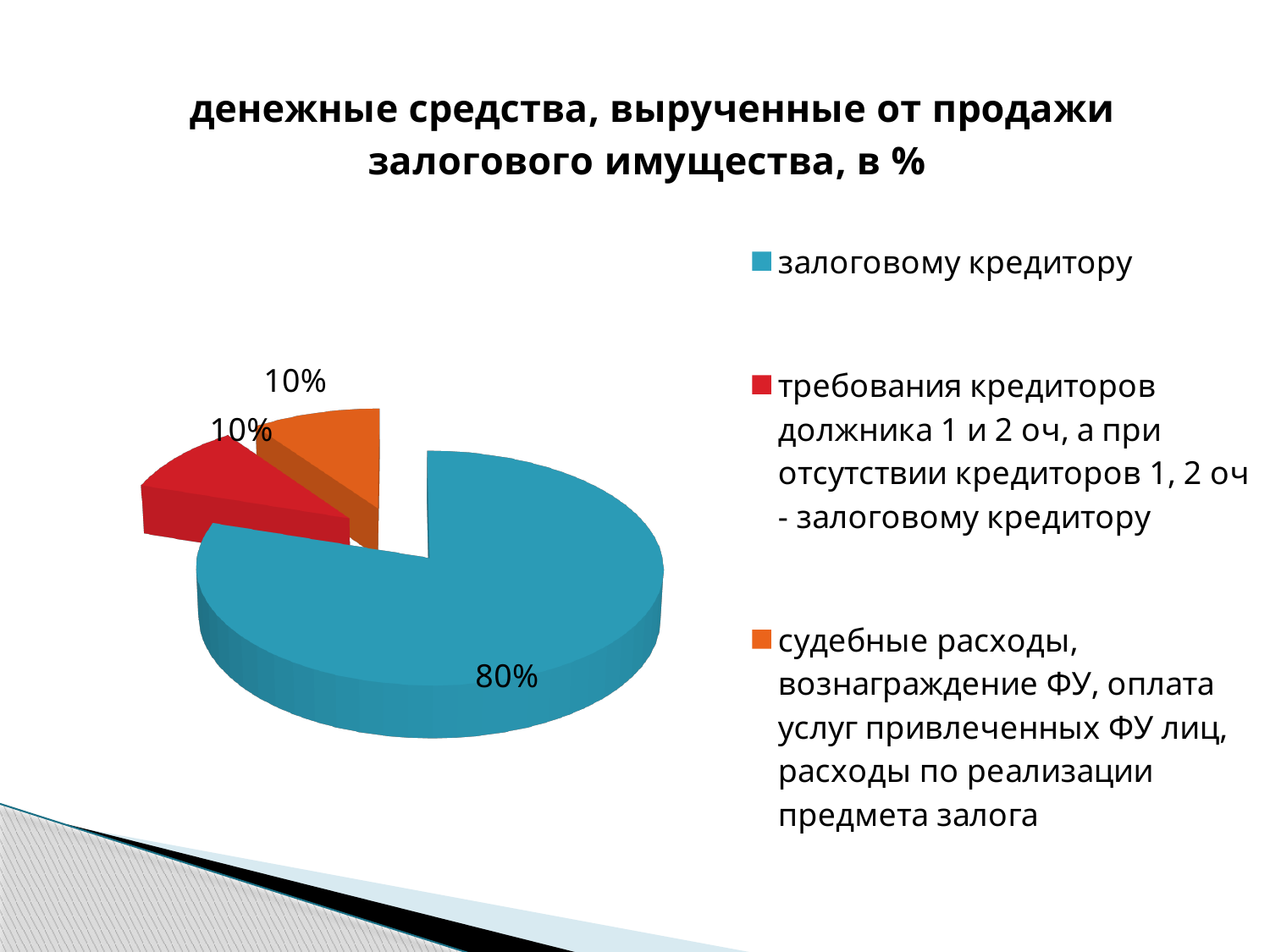
What share of the pie goes to "залоговому кредитору"? 80% What share of the pie is labelled for "судебные расходы, вознаграждение ФУ, оплата услуг привлеченных ФУ лиц, расходы по реализации предмета залога"? 10% How many entries does the legend list? 3 What is the combined share of the two 10% slices? 20% What kind of chart is shown on the slide? pie chart How many slices does the pie chart have? 3 What is the title of the chart? денежные средства, вырученные от продажи залогового имущества, в % What is the difference between the share for "залоговому кредитору" and the share for "судебные расходы, вознаграждение ФУ, оплата услуг привлеченных ФУ лиц, расходы по реализации предмета залога"? 70% Which category has the largest slice of the pie? залоговому кредитору What colour is the slice for "залоговому кредитору"? blue Which is larger: the share for "залоговому кредитору" or the share for "требования кредиторов должника 1 и 2 оч, а при отсутствии кредиторов 1, 2 оч - залоговому кредитору"? залоговому кредитору What share of the pie is labelled for "требования кредиторов должника 1 и 2 оч, а при отсутствии кредиторов 1, 2 оч - залоговому кредитору"? 10%